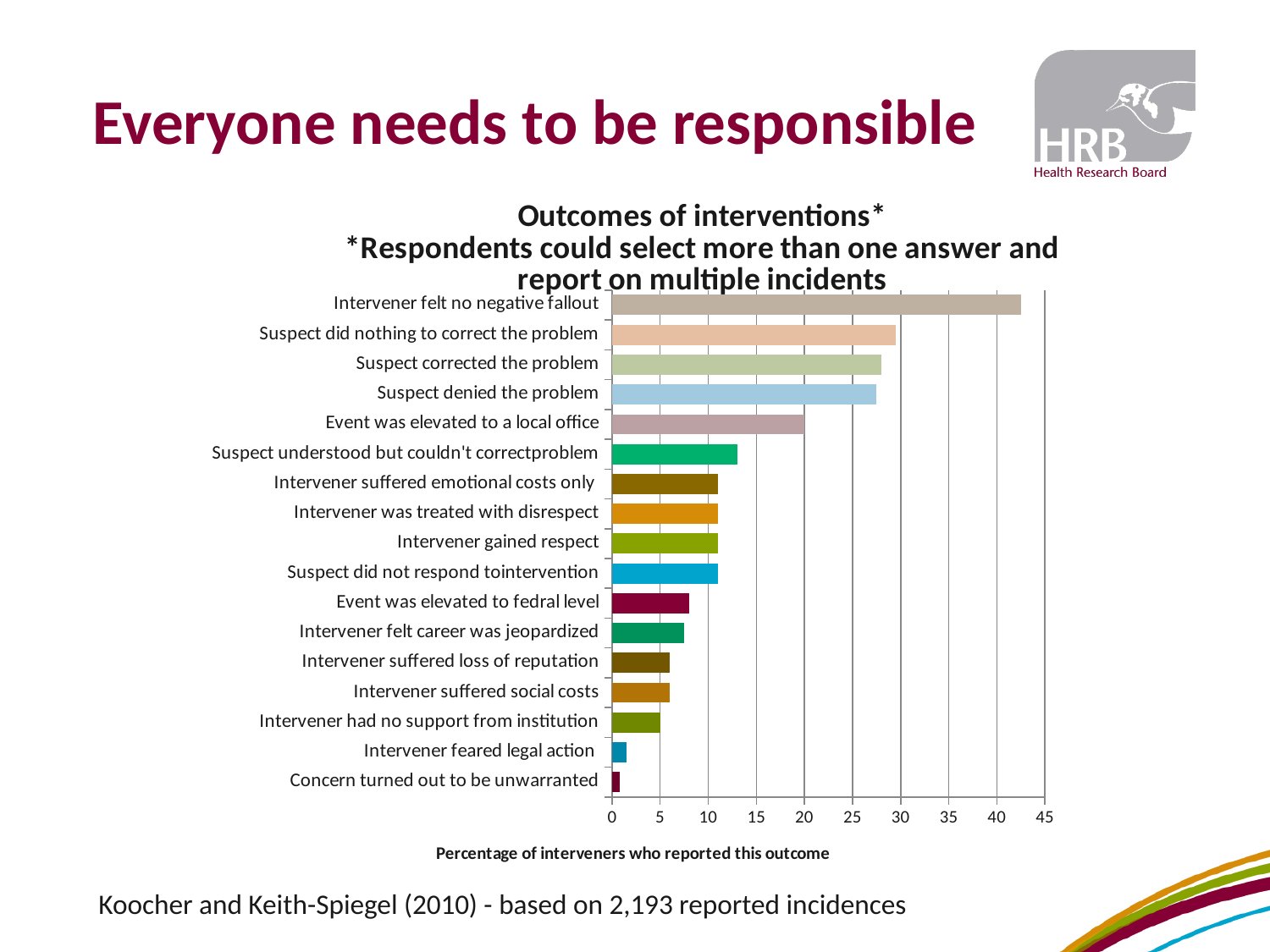
How many outcome categories are plotted in the chart? 17 What kind of chart is shown on the slide? bar chart Is the value for 'Intervener feared legal action' greater or less than 5? less Is the value for 'Suspect did nothing to correct the problem' greater or less than 25? greater Which outcome has the lowest percentage of interveners reporting it? Concern turned out to be unwarranted Is the value for 'Event was elevated to fedral level' greater or less than 10? less What is the label on the horizontal axis of the chart? Percentage of interveners who reported this outcome Which is larger: the value for 'Suspect denied the problem' or the value for 'Event was elevated to a local office'? Suspect denied the problem Which outcome has the highest percentage of interveners reporting it? Intervener felt no negative fallout Do the bar values increase or decrease going from the top of the chart to the bottom? decrease